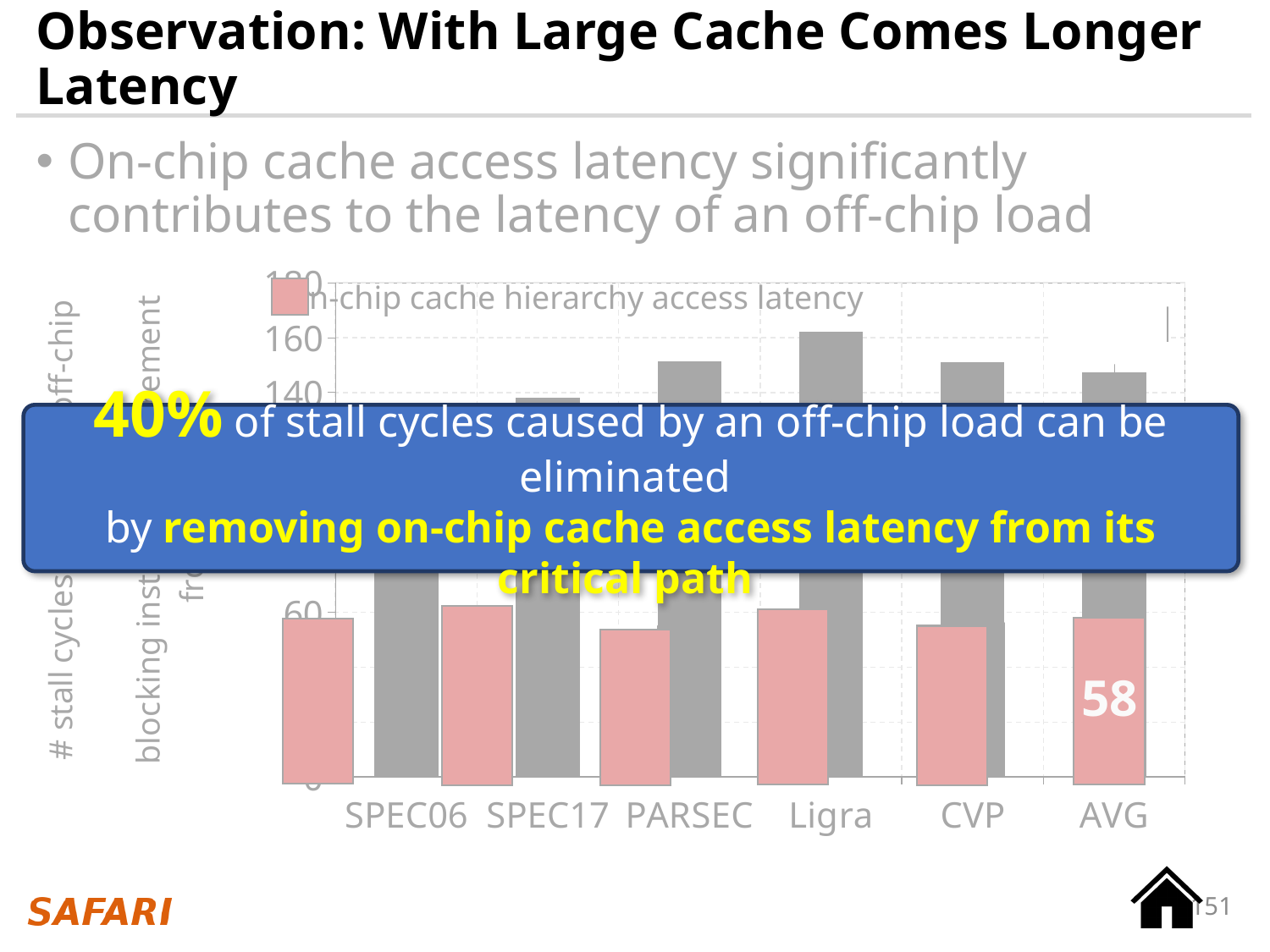
What kind of chart is shown on the slide? bar chart Which category has the tallest gray bar? Ligra How many categories are shown on the x axis of the chart? 6 Which has the larger gray bar, PARSEC or SPEC17? PARSEC What is the value of the on-chip cache hierarchy access latency bar for AVG? 58 What is the label of the last category on the x axis? AVG Which has the larger gray bar, Ligra or CVP? Ligra Is the on-chip cache hierarchy access latency bar for PARSEC greater or less than 60? less What series name is shown in the chart legend? on-chip cache hierarchy access latency